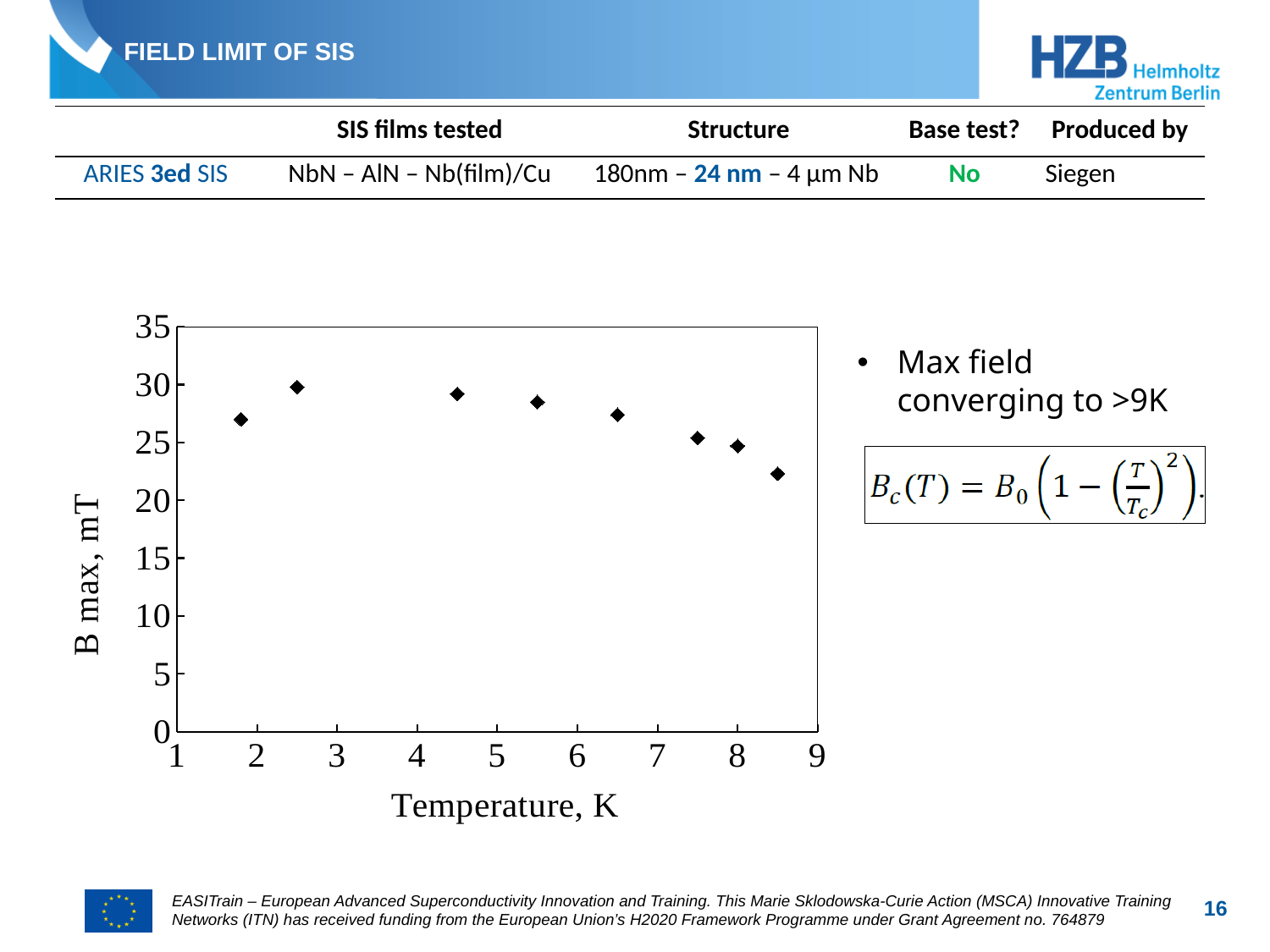
Is the B max value at the highest temperature point (about 8.5 K) greater or less than 20? greater Are all plotted B max values greater or less than 20 mT? greater Is the B max value at the lowest temperature point (about 1.8 K) greater or less than 25? greater Which has the larger B max value: the point at about 2.5 K or the point at about 8.5 K? the point at about 2.5 K Do the B max values rise or fall as temperature increases from about 2.5 K to 8.5 K? fall How many data points are plotted in the chart? 8 What is the label of the y axis of the chart? B max, mT What is the label of the x axis of the chart? Temperature, K What kind of chart is shown on the slide? scatter chart